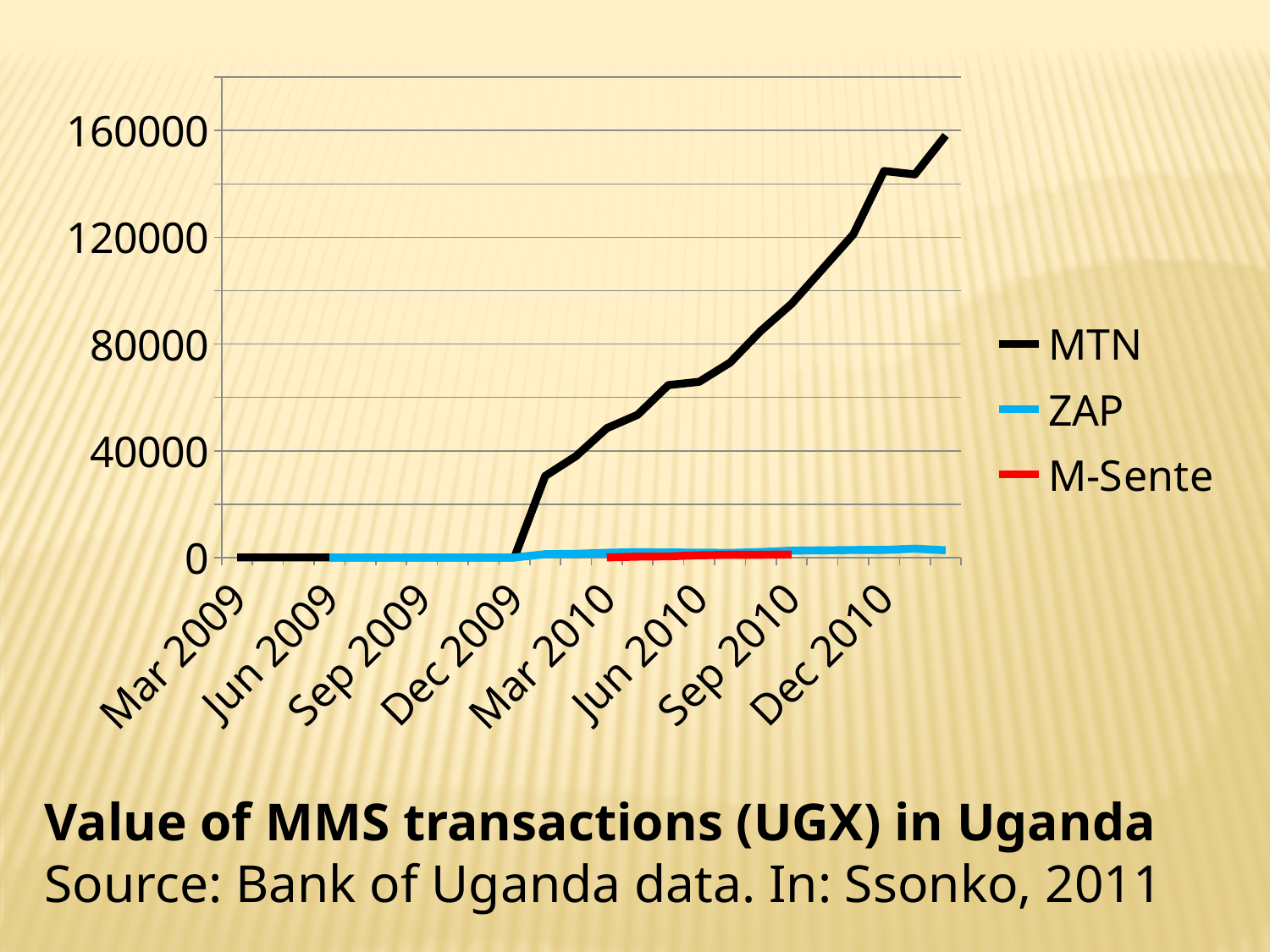
What is the title of the chart? Value of MMS transactions (UGX) in Uganda What colour is the M-Sente line in the legend? red Is the value for MTN at Sep 2010 greater or less than 80000? greater Is the value for ZAP at Dec 2010 greater or less than 40000? less What kind of chart is shown on the slide? line chart How many series does the legend list? 3 Which series has the highest value at Dec 2010? MTN Is the value for MTN at Mar 2010 greater or less than 40000? greater Does the MTN series rise or fall from Mar 2010 to Dec 2010? rise Which is larger at Dec 2010, the value for MTN or the value for ZAP? MTN How many date labels are shown on the x axis? 8